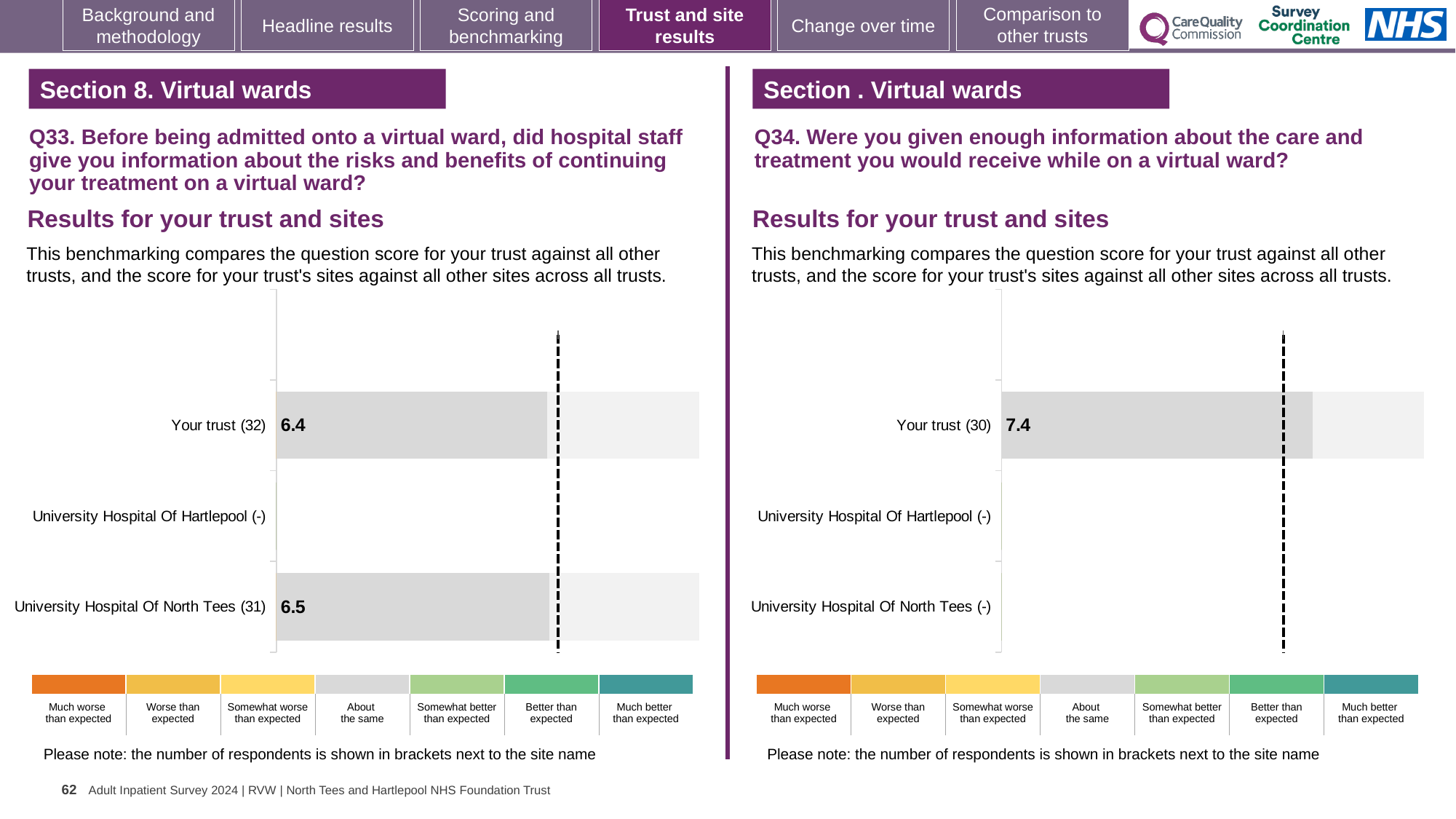
In the Q33 chart on the left, how many respondents are shown in brackets for University Hospital Of North Tees? 31 In the Q34 chart on the right, how many categories are listed on the vertical axis? 3 In the Q33 chart on the left, what is the difference between the score for University Hospital Of North Tees and the score for Your trust? 0.1 In the Q33 chart on the left, what is the score for University Hospital Of North Tees? 6.5 What kind of chart is the Q33 chart on the left? Bar chart In the Q33 chart on the left, what is the score for Your trust? 6.4 In the Q33 chart on the left, how many categories are listed on the vertical axis? 3 In the Q34 chart on the right, how many respondents are shown in brackets for Your trust? 30 In the Q33 chart on the left, how many respondents are shown in brackets for Your trust? 32 In the Q33 chart on the left, which has the higher score: Your trust or University Hospital Of North Tees? University Hospital Of North Tees In the Q34 chart on the right, what is the score for Your trust? 7.4 In the Q34 chart on the right, which category has the highest score shown? Your trust